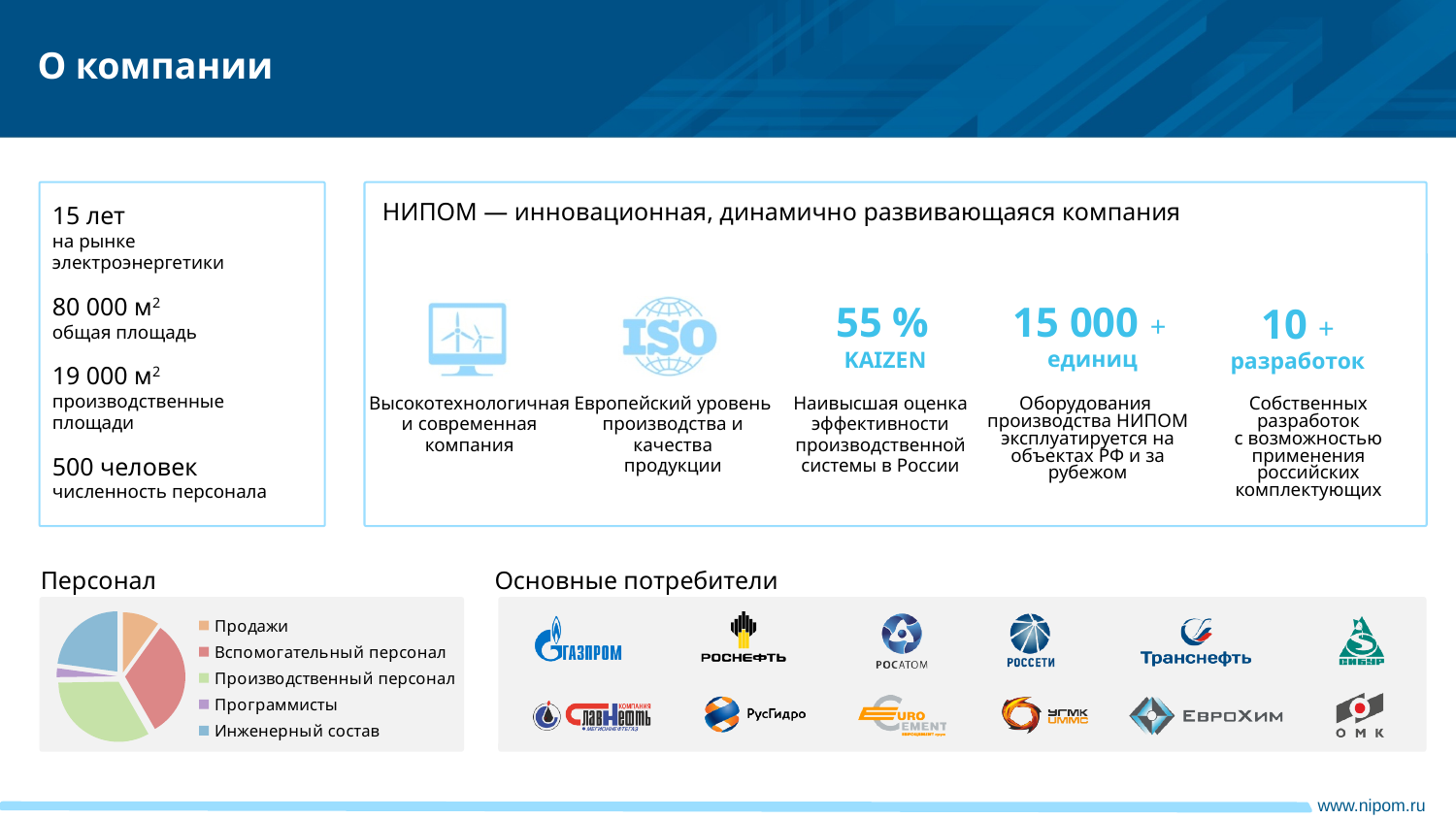
In the "Персонал" pie chart, which slice is larger: Производственный персонал or Продажи? Производственный персонал In the "Персонал" pie chart, which category is shown in purple? Программисты In the "Персонал" pie chart, which slice is larger: Продажи or Программисты? Продажи How many categories does the "Персонал" pie chart show? 5 How many entries does the legend of the "Персонал" pie chart list? 5 What kind of chart is shown under the heading "Персонал"? pie chart In the "Персонал" pie chart, which slice is larger: Вспомогательный персонал or Программисты? Вспомогательный персонал What is the title of the pie chart on the slide? Персонал In the "Персонал" pie chart, which category has the smallest slice? Программисты